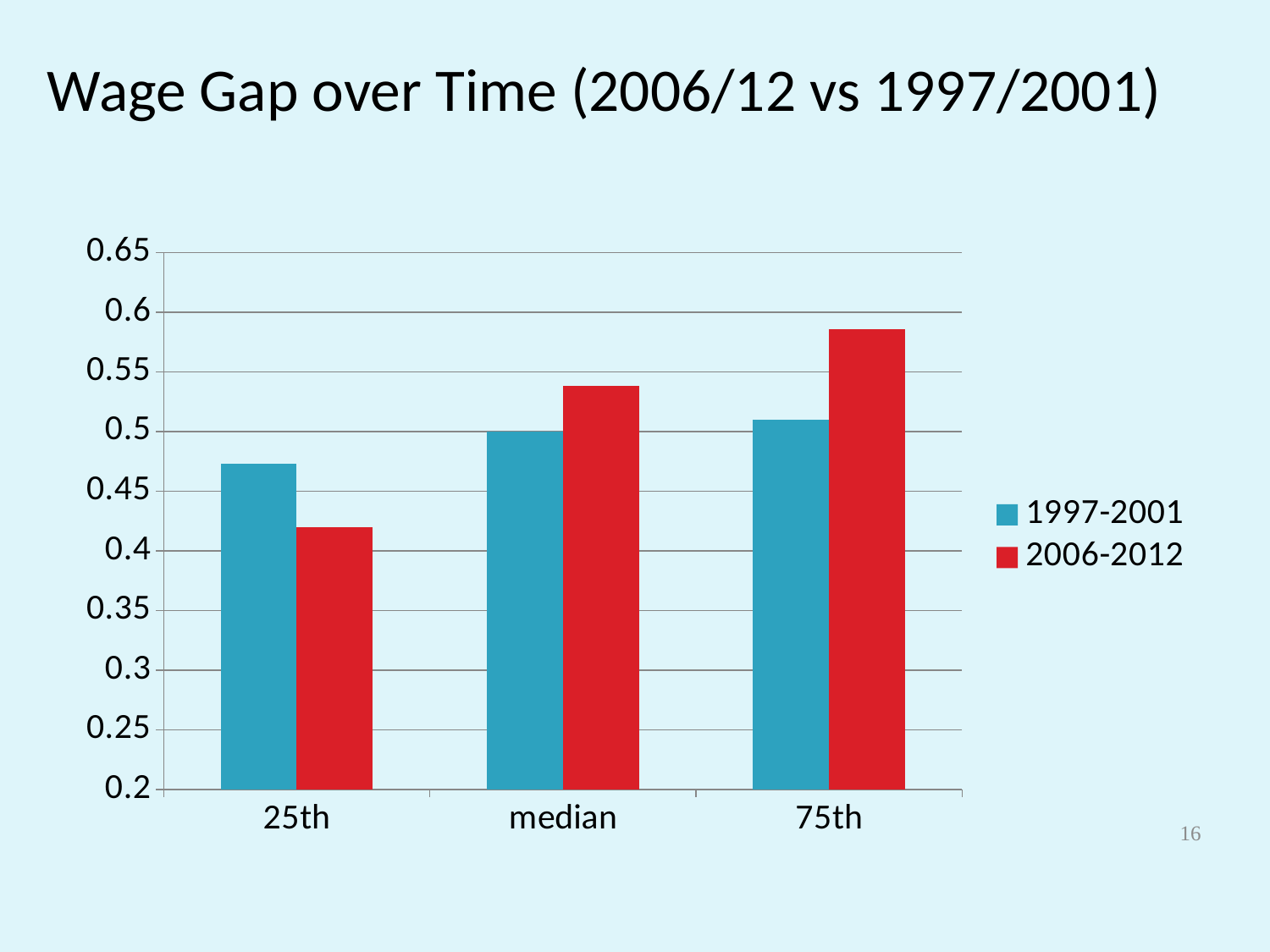
Is the value for 1997-2001 at the 25th percentile greater or less than 0.45? greater Is the value for 2006-2012 at the 25th percentile greater or less than 0.45? less Do the values for the 2006-2012 series rise or fall from 25th to 75th along the x axis? rise Which category has the highest value for the 2006-2012 series? 75th Which category has the lowest value for the 2006-2012 series? 25th At the 25th percentile, which series has the larger value, 1997-2001 or 2006-2012? 1997-2001 What colour represents the 2006-2012 series in the legend? red What kind of chart is shown on the slide? bar chart Is the value for 2006-2012 at the 75th percentile greater or less than 0.55? greater How many series does the legend list? 2 How many categories are shown on the x axis? 3 At the median, which series has the larger value, 1997-2001 or 2006-2012? 2006-2012